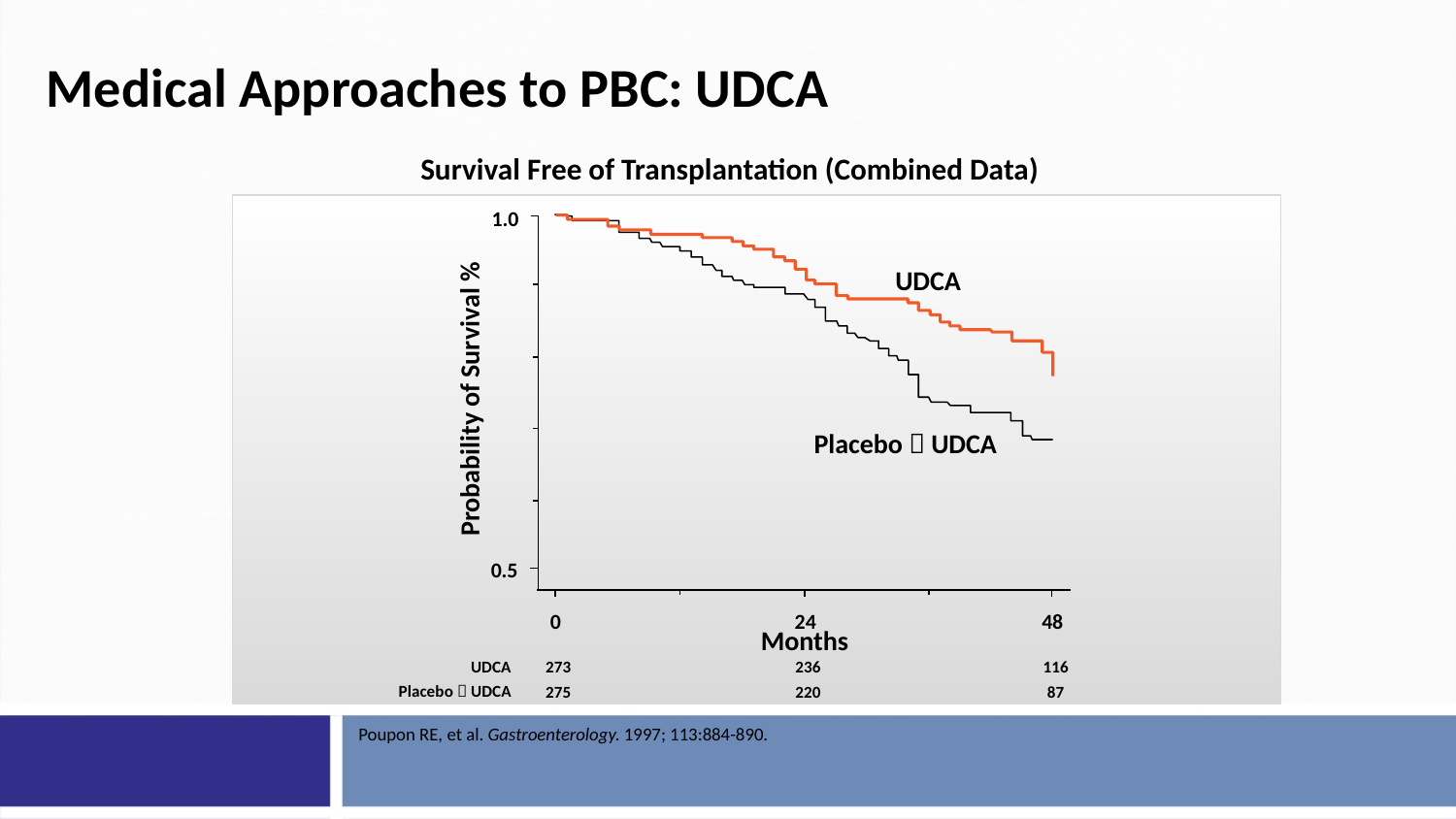
At 24 months, which group has more patients at risk, UDCA or Placebo → UDCA? UDCA How many patients were at risk in the UDCA group at 0 months? 273 Do the survival curves rise or fall as months increase? fall What is the difference between the number at risk in the UDCA group and the Placebo → UDCA group at 48 months? 29 How many patients were at risk in the UDCA group at 24 months? 236 How many patients were at risk in the Placebo → UDCA group at 48 months? 87 Is the probability of survival for the Placebo → UDCA group at 48 months greater or less than 0.5? greater What is the label of the y axis of the chart? Probability of Survival % What is the title of the chart? Survival Free of Transplantation (Combined Data) How many patients were at risk in the Placebo → UDCA group at 0 months? 275 What kind of chart is shown on the slide? line chart How many groups (series) are plotted on the chart? 2